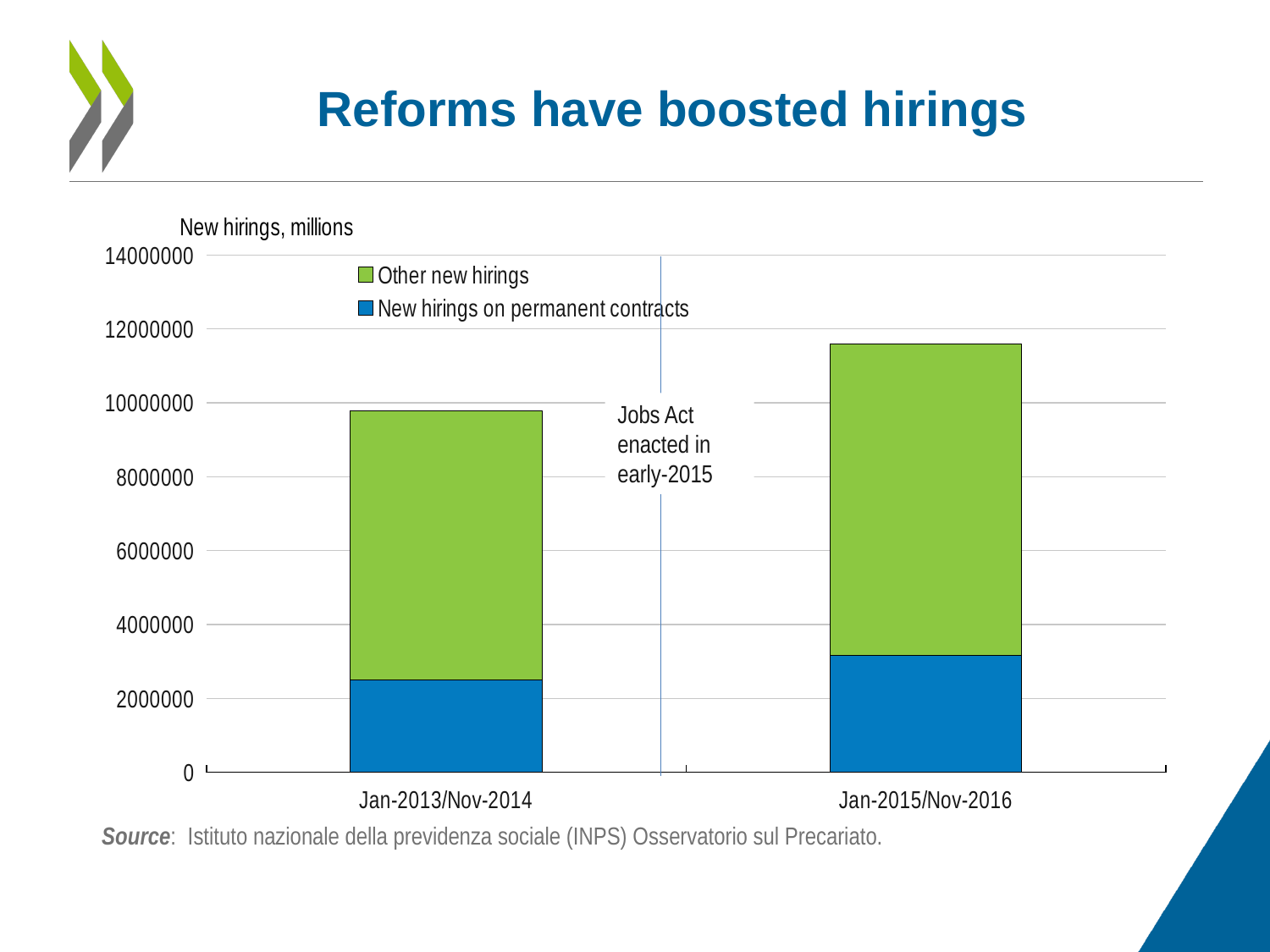
Is the total new hirings for Jan-2013/Nov-2014 greater or less than 10000000? less How many series does the legend list? 2 Is the value for new hirings on permanent contracts in Jan-2013/Nov-2014 greater or less than 2000000? greater What kind of chart is shown on the slide? Stacked bar chart Do total new hirings rise or fall from Jan-2013/Nov-2014 to Jan-2015/Nov-2016? rise Which period has the larger value for new hirings on permanent contracts? Jan-2015/Nov-2016 Which period has the higher total of new hirings? Jan-2015/Nov-2016 What is the title of the slide? Reforms have boosted hirings How many periods (categories) are shown on the x axis? 2 Is the total new hirings for Jan-2015/Nov-2016 greater or less than 10000000? greater What event does the annotation on the chart say happened in early-2015? Jobs Act enacted